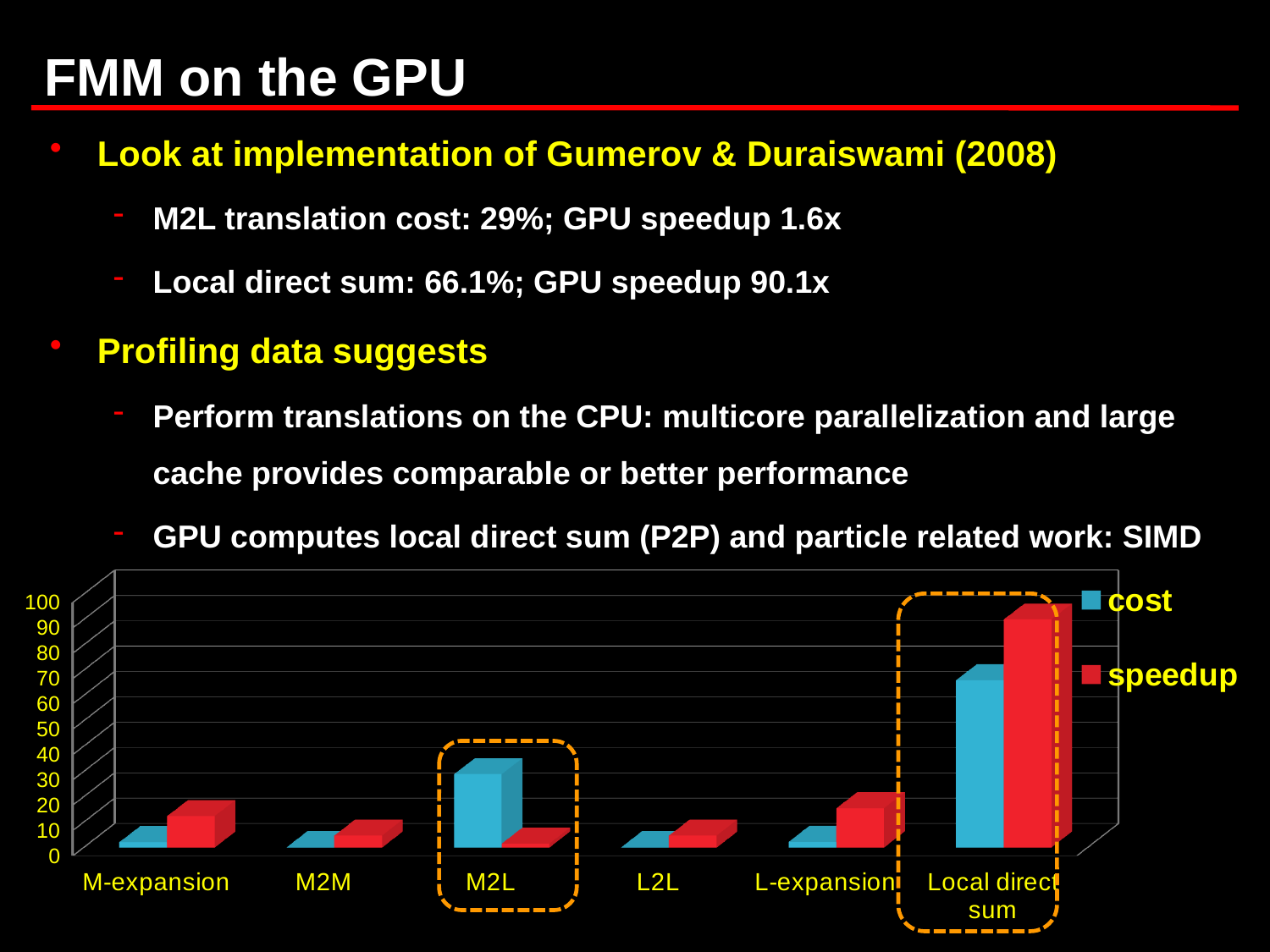
How many series does the chart legend list? 2 What kind of chart is shown on the slide? bar chart For Local direct sum, which is larger, the cost bar or the speedup bar? speedup Which category has the highest speedup bar? Local direct sum What are the two series names listed in the chart legend? cost and speedup Is the cost value for Local direct sum greater or less than 50? greater Which category has the highest cost bar? Local direct sum Is the speedup value for Local direct sum greater or less than 80? greater For M2L, which is larger, the cost bar or the speedup bar? cost Is the cost value for M2L greater or less than 20? greater How many categories are shown on the x axis of the chart? 6